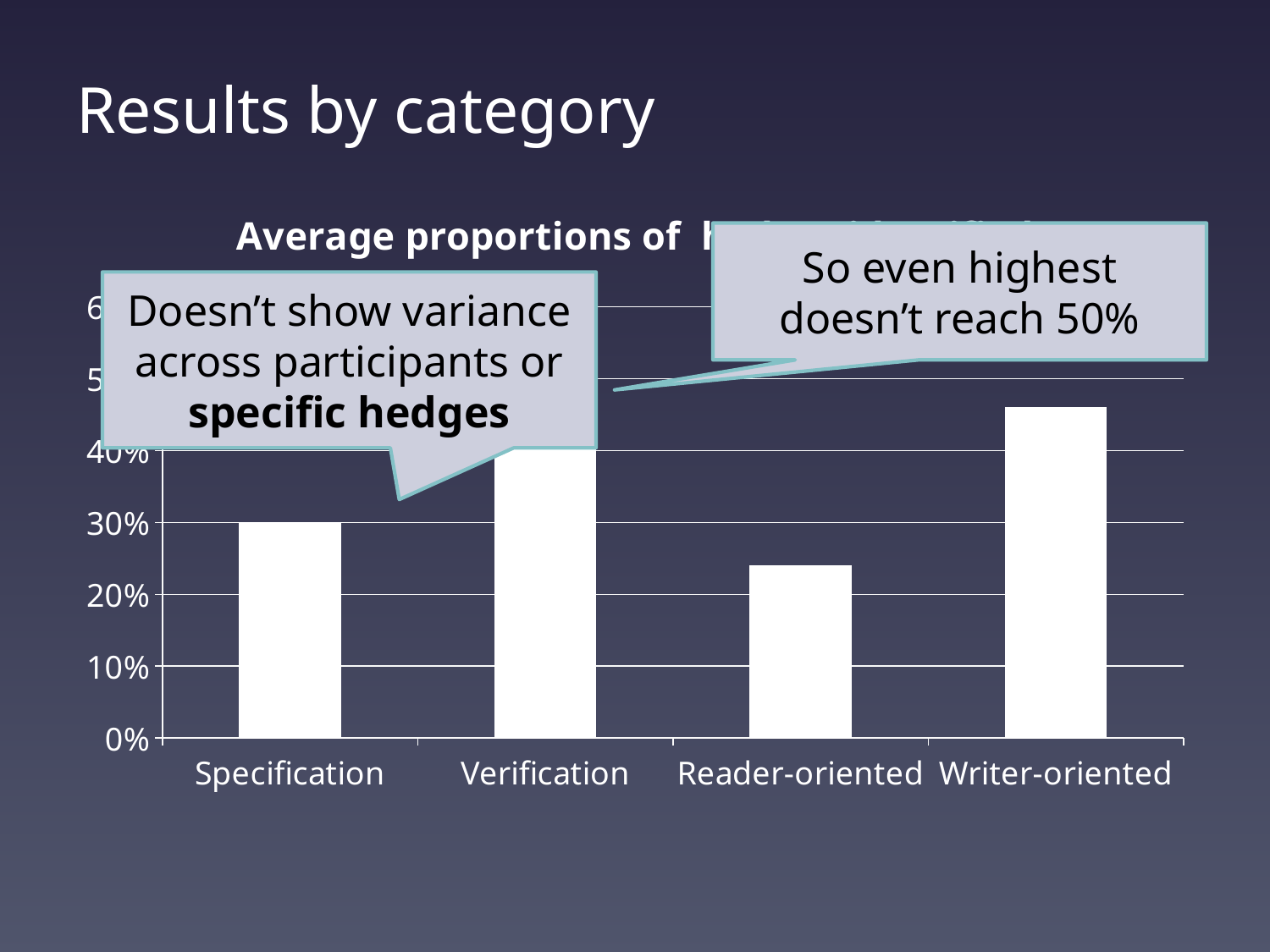
Which is larger, the value for Writer-oriented or the value for Specification? Writer-oriented What kind of chart is shown on the slide? bar chart How many categories are shown on the x axis of the chart? 4 Is the value for Writer-oriented greater or less than 50%? less Which category has the lowest bar in the chart? Reader-oriented Is the value for Reader-oriented greater or less than 30%? less What colour are the bars in the chart? white Which is larger, the value for Specification or the value for Reader-oriented? Specification Is the value for Writer-oriented greater or less than 40%? greater What is the value for Specification? 30% What is the label of the first category on the x axis? Specification